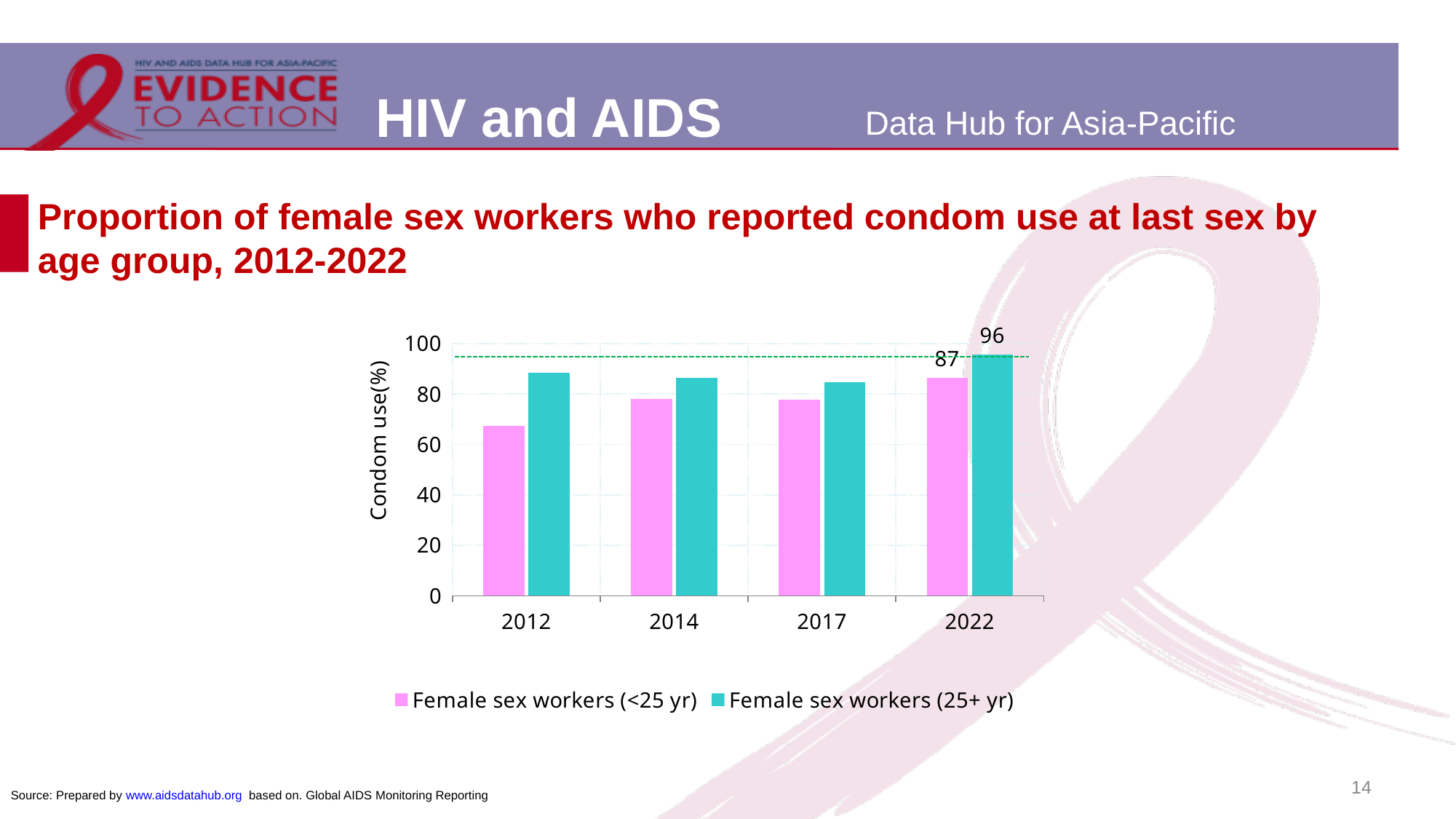
In 2022, which series has the larger value: Female sex workers (<25 yr) or Female sex workers (25+ yr)? Female sex workers (25+ yr) Is the value for Female sex workers (25+ yr) in 2012 greater or less than 80? greater What kind of chart is shown on the slide? bar chart Which bar is the lowest in the chart? Female sex workers (<25 yr) in 2012 Is the value for Female sex workers (<25 yr) in 2012 greater or less than 80? less What is the difference between the 2022 values for Female sex workers (25+ yr) and Female sex workers (<25 yr)? 9 What is the value for Female sex workers (<25 yr) in 2022? 87 Which bar is the highest in the chart? Female sex workers (25+ yr) in 2022 What is the value for Female sex workers (25+ yr) in 2022? 96 What is the label of the y axis? Condom use(%) How many years are shown on the x axis? 4 How many series does the legend list? 2